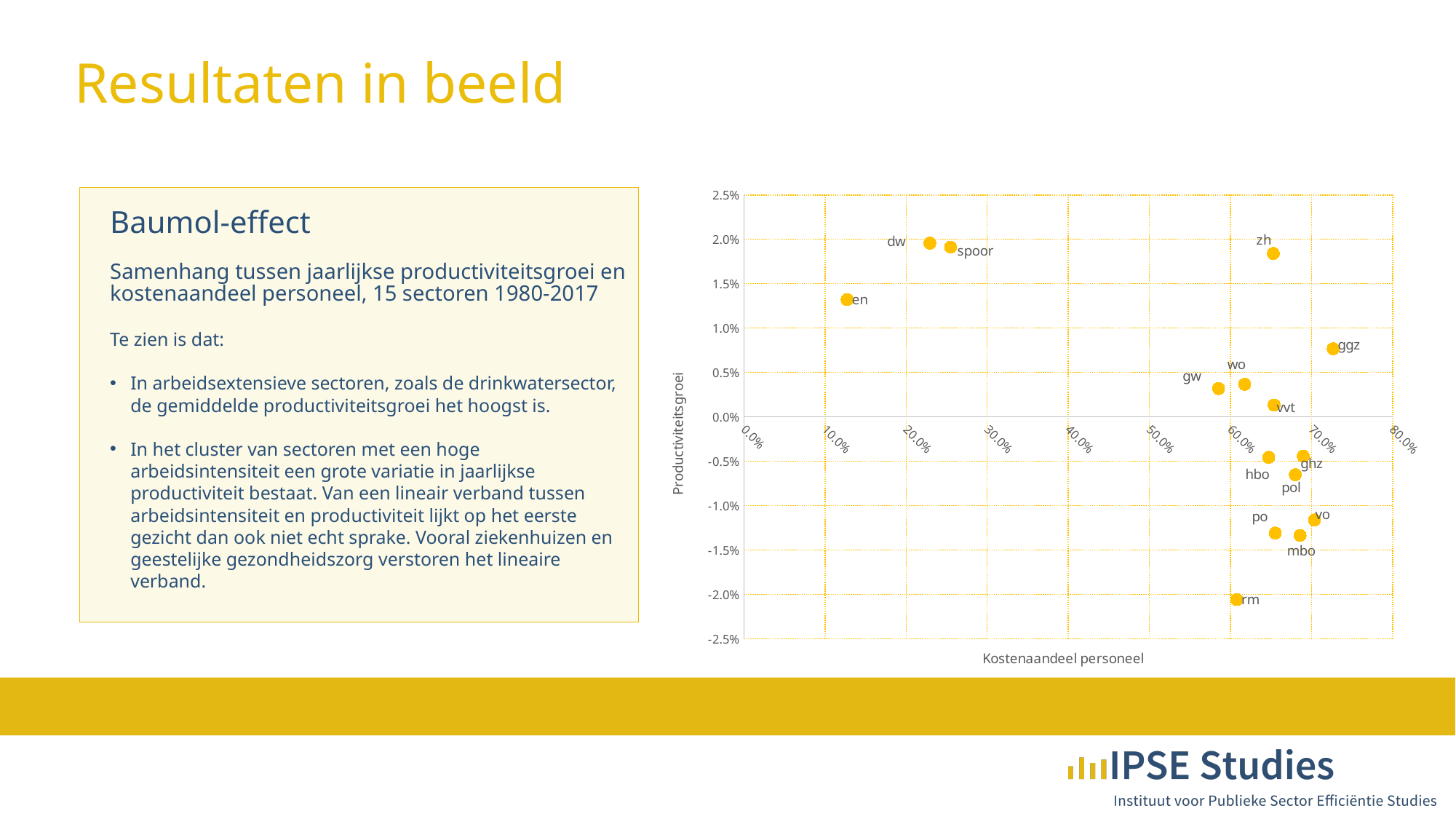
Which sector has a higher productivity growth, dw or ggz? dw How many data points (sectors) are plotted in the chart? 15 Which sector has the lowest cost share of personnel (Kostenaandeel personeel) in the chart? en Which sector has the lowest productivity growth (Productiviteitsgroei) in the chart? rm Is the productivity growth for rm greater or less than -1.5%? less Is the cost share of personnel for dw greater or less than 30.0%? less Which sector has the highest cost share of personnel (Kostenaandeel personeel) in the chart? ggz What kind of chart is shown on the slide? scatter chart What is the title of the horizontal axis of the chart? Kostenaandeel personeel What is the title of the vertical axis of the chart? Productiviteitsgroei Which sector has a higher productivity growth, po or rm? po Is the productivity growth for en greater or less than 1.0%? greater